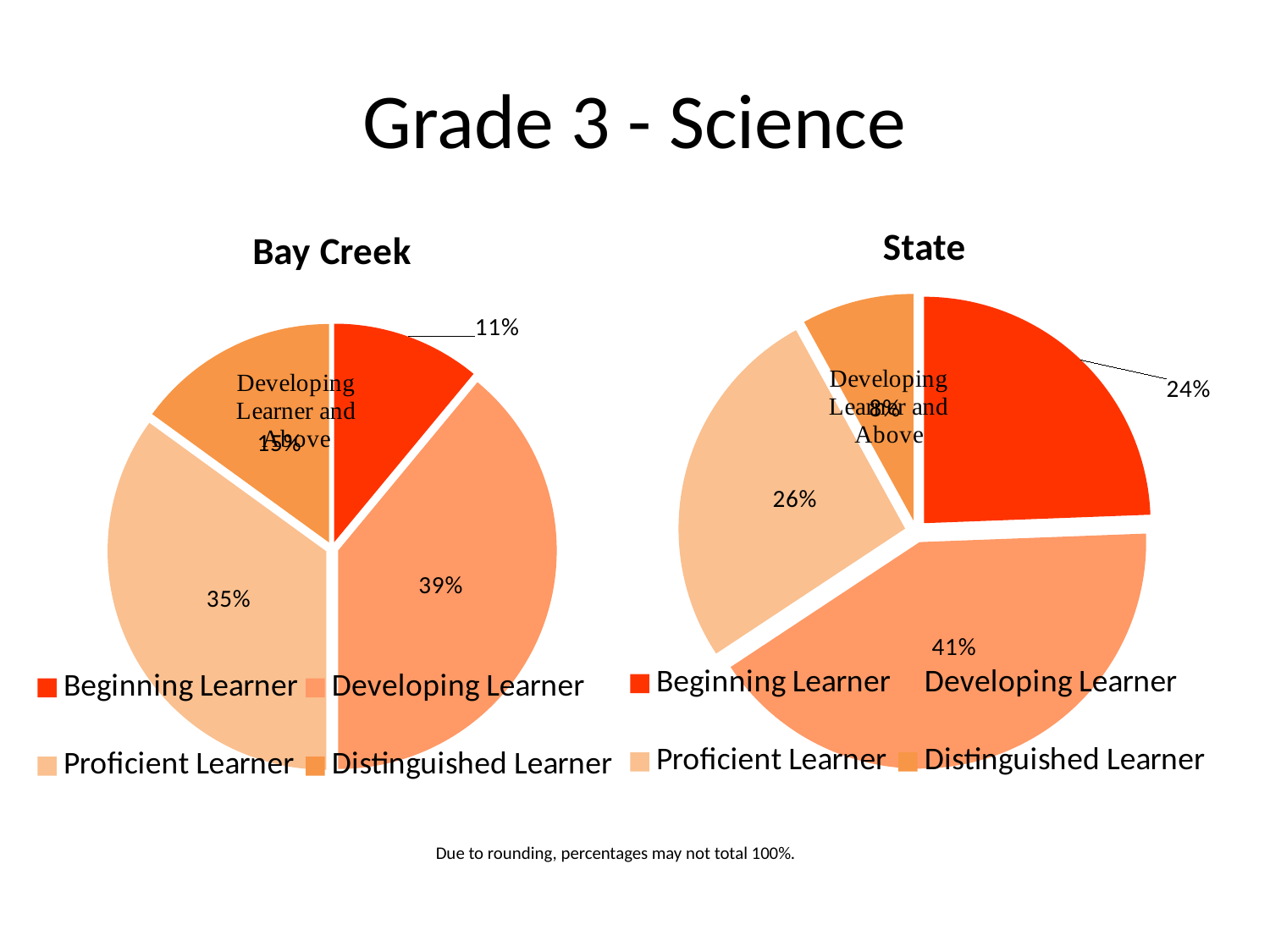
Is the Beginning Learner share larger in the Bay Creek chart or the State chart? State In the State chart, what percentage is shown for Proficient Learner? 26% What type of chart is the Bay Creek chart? Pie chart In the State chart, what percentage is shown for Beginning Learner? 24% In the Bay Creek chart, what percentage is shown for Proficient Learner? 35% In the State chart, what percentage is shown for Developing Learner? 41% In the Bay Creek chart, what percentage is shown for Beginning Learner? 11% In the Bay Creek chart, what percentage is shown for Developing Learner? 39% In the State chart, what is the difference in percentage points between Developing Learner and Beginning Learner? 17 percentage points How many categories does the legend of the State chart list? 4 In the Bay Creek chart, which category has the largest slice? Developing Learner In the State chart, which category has the smallest slice? Distinguished Learner